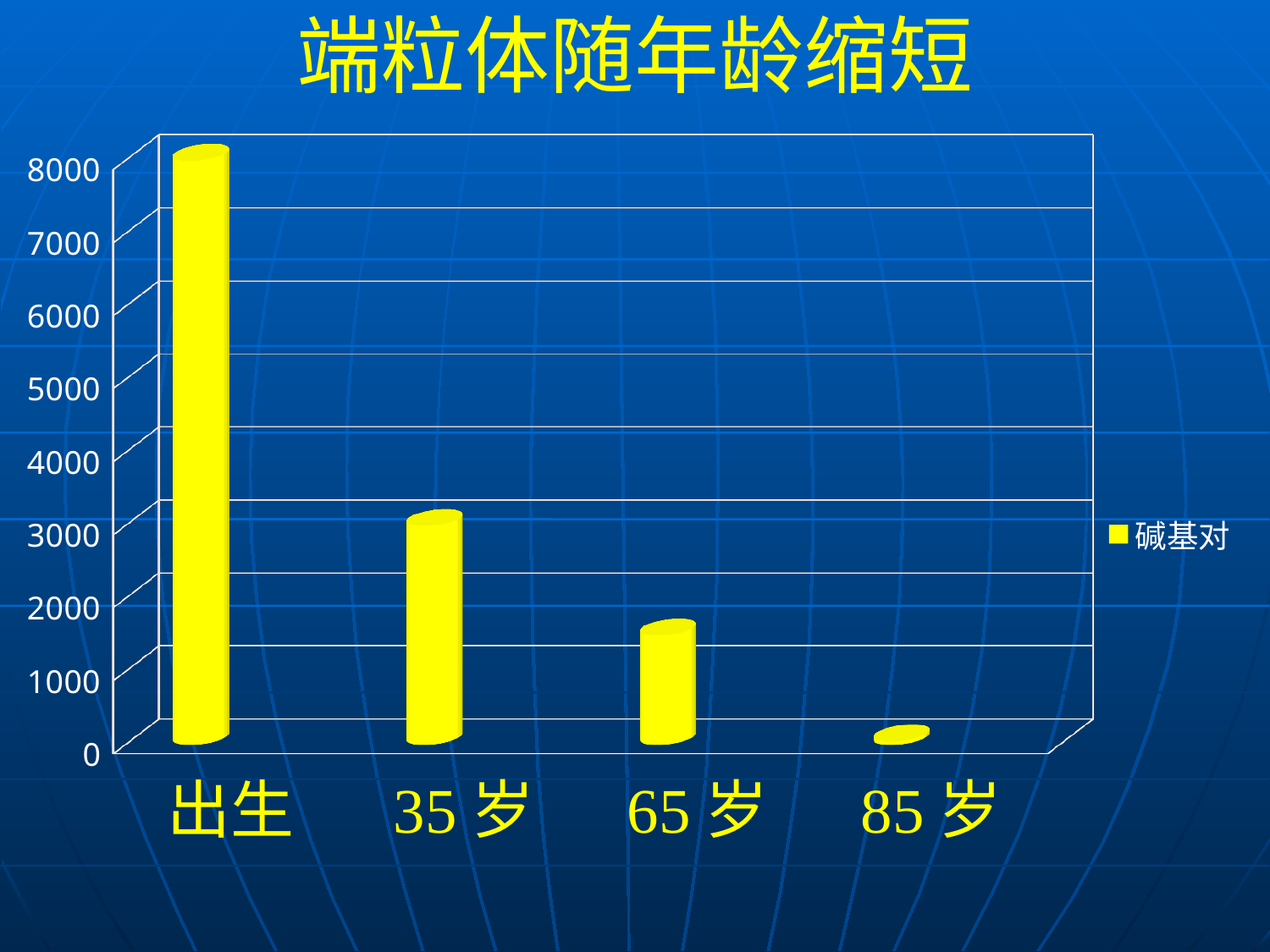
Which category has the highest value? 出生 How many categories are shown on the x axis? 4 What series name does the legend list? 碱基对 Which category has the lowest value? 85 岁 Which is larger, the value for 35 岁 or the value for 65 岁? 35 岁 Is the value for 出生 greater or less than 7000? greater What kind of chart is shown on the slide? bar chart Is the value for 35 岁 greater or less than 4000? less What is the title of the chart? 端粒体随年龄缩短 Do the values rise or fall from 出生 to 85 岁 along the x axis? fall Is the value for 65 岁 greater or less than 1000? greater How many series does the legend list? 1